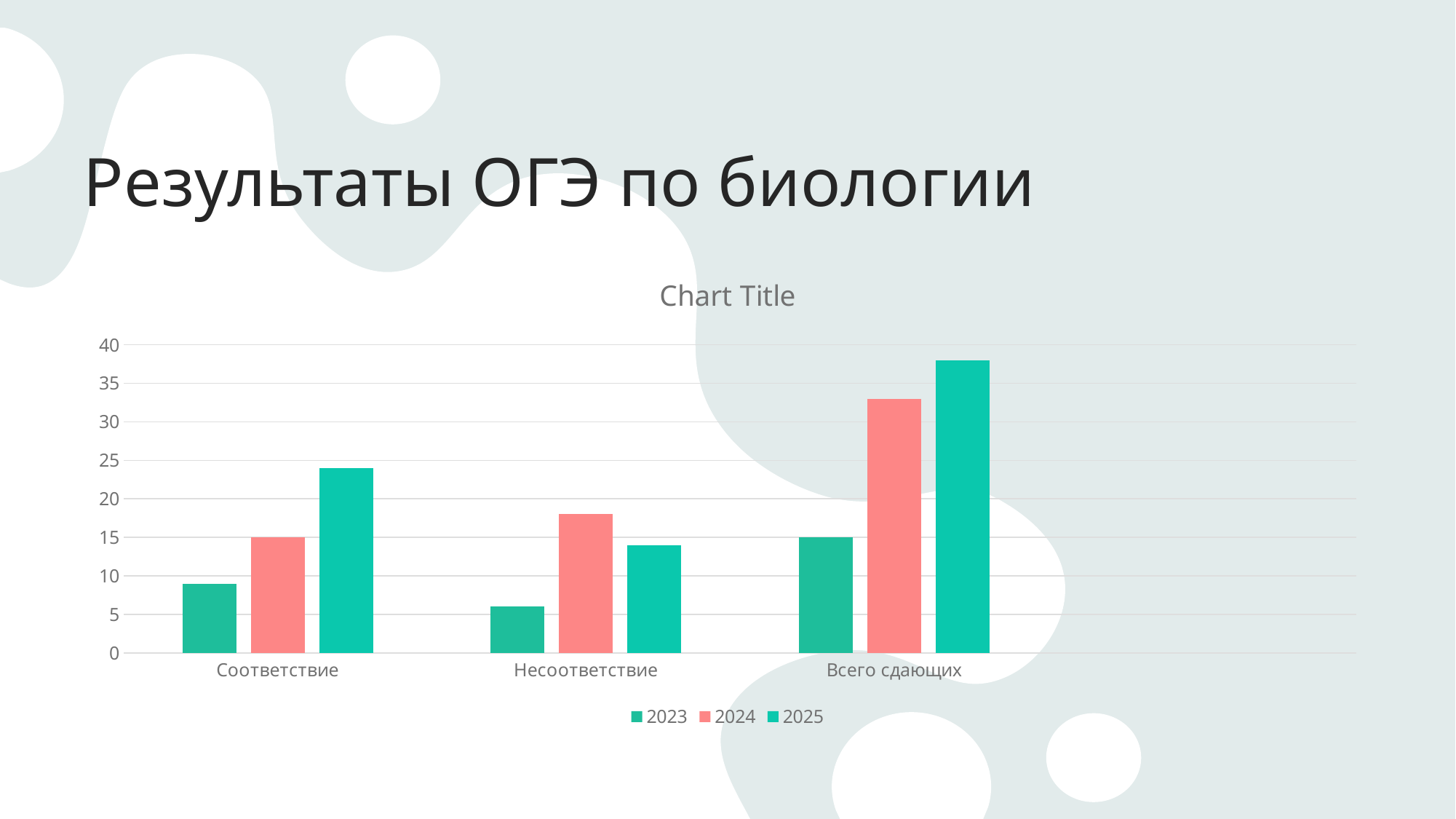
In the Несоответствие category, which is larger: the value for 2024 or the value for 2025? 2024 How many categories are shown on the x axis? 3 What kind of chart is shown on the slide? bar chart How many series does the legend list? 3 What is the value for 2024 in the Соответствие category? 15 Is the value for 2025 in the Соответствие category greater or less than 20? greater Which year has the highest value in the Всего сдающих category? 2025 What is the title shown above the chart? Chart Title Is the value for 2023 in the Несоответствие category greater or less than 10? less Is the value for 2025 in the Всего сдающих category greater or less than 35? greater Which year has the lowest value in the Несоответствие category? 2023 What is the value for 2023 in the Всего сдающих category? 15